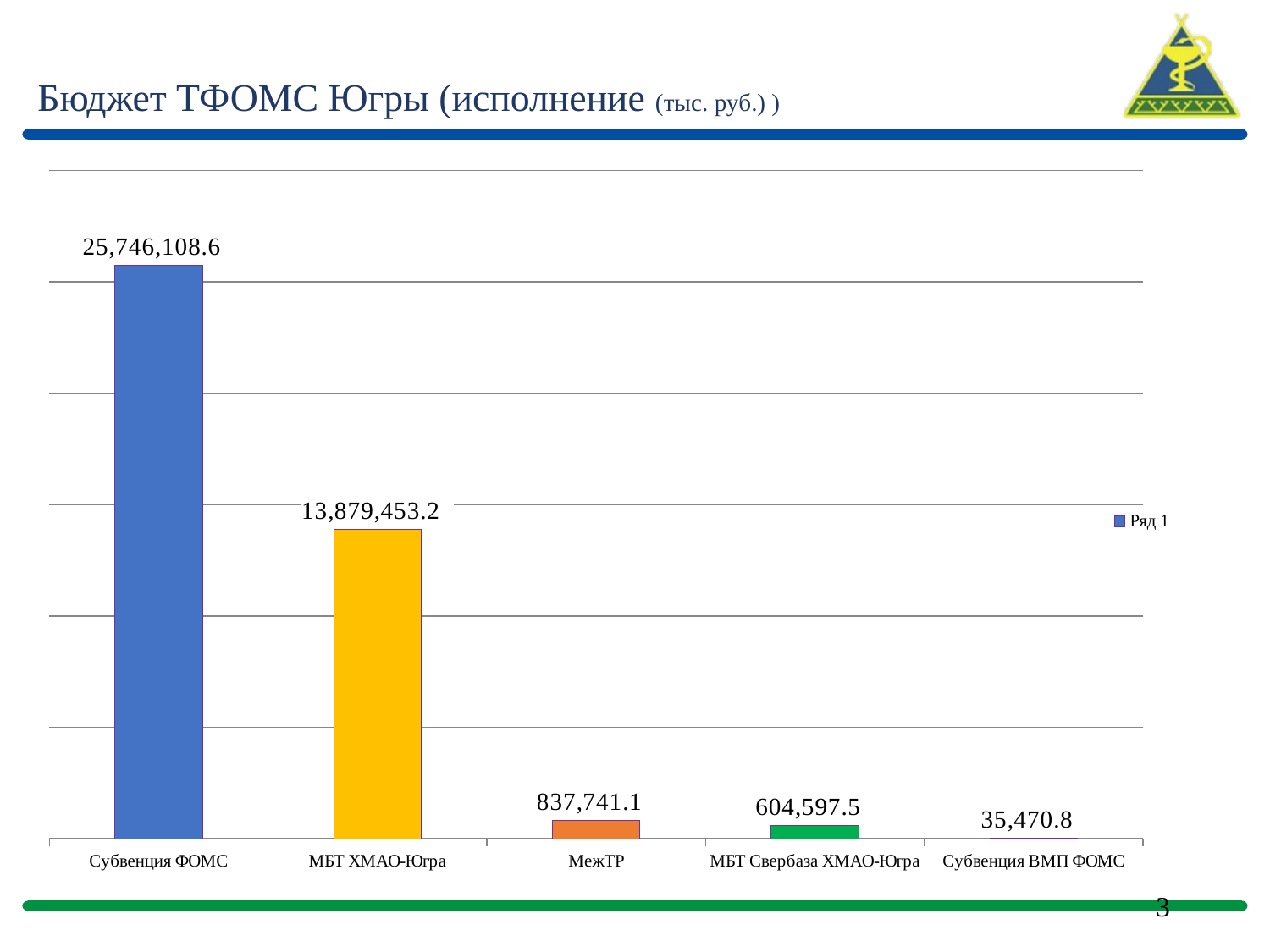
Which category has the lowest value? Субвенция ВМП ФОМС What is the difference between the values for Субвенция ФОМС and МБТ ХМАО-Югра? 11,866,655.4 What is the value for Субвенция ФОМС? 25,746,108.6 What is the value for МБТ Свербаза ХМАО-Югра? 604,597.5 How many categories are shown in the chart? 5 Which category has the highest value? Субвенция ФОМС What is the value for МежТР? 837,741.1 What kind of chart is shown on the slide? Bar chart Which is larger, the value for МежТР or the value for МБТ Свербаза ХМАО-Югра? МежТР What is the value for МБТ ХМАО-Югра? 13,879,453.2 What is the value for Субвенция ВМП ФОМС? 35,470.8 What is the difference between the values for МежТР and МБТ Свербаза ХМАО-Югра? 233,143.6